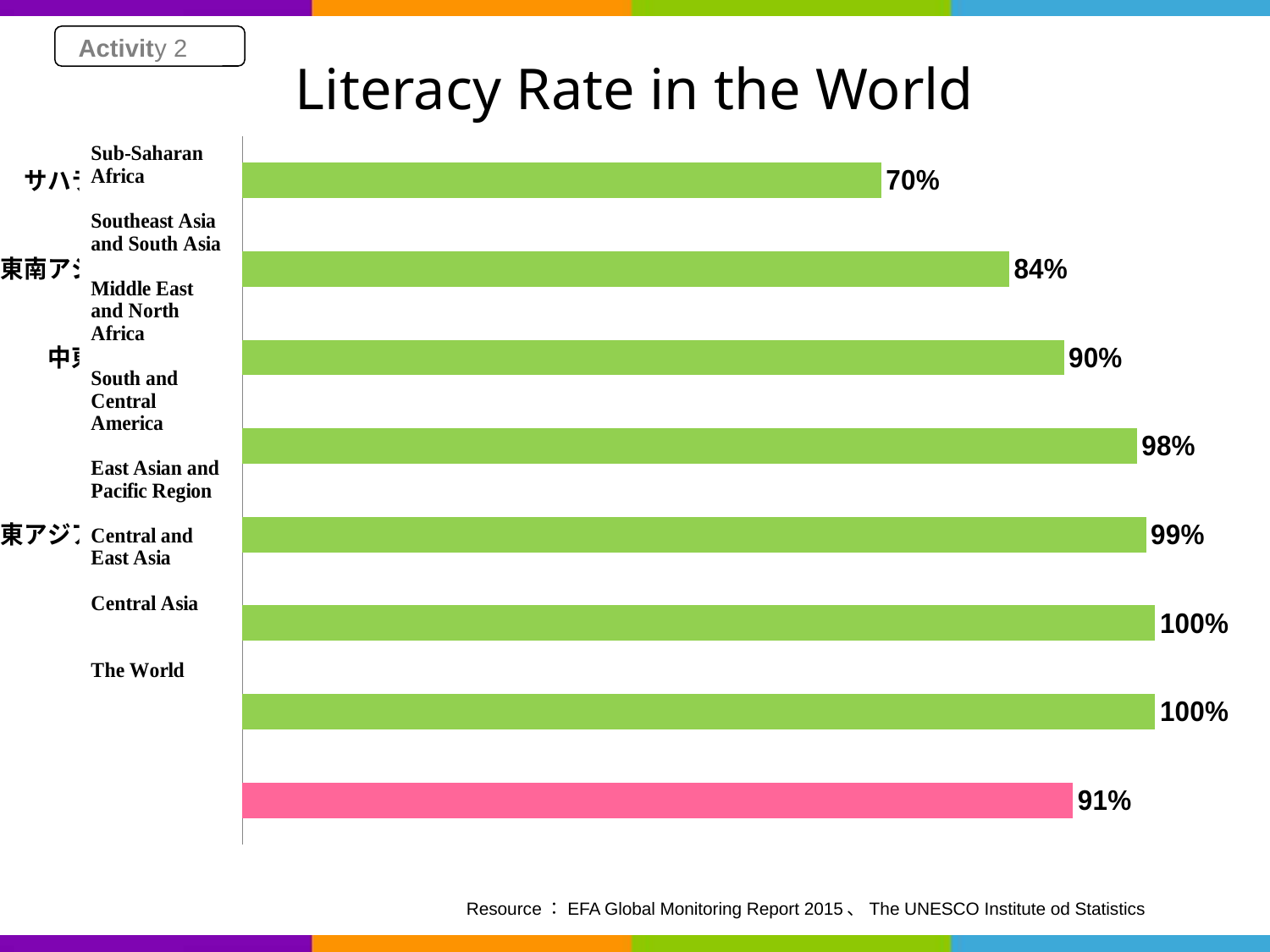
Which is larger, the literacy rate for South and Central America or for Middle East and North Africa? South and Central America What kind of chart is shown on the slide? Bar chart What is the literacy rate shown for Middle East and North Africa? 90% What is the literacy rate shown for Sub-Saharan Africa? 70% What is the difference between the literacy rate of The World and that of Sub-Saharan Africa? 21% What is the title of the chart? Literacy Rate in the World What is the literacy rate shown for The World? 91% How many bars are plotted on the chart? 8 Which region has the lowest literacy rate on the chart? Sub-Saharan Africa What is the literacy rate shown for Southeast Asia and South Asia? 84% Which bar is shown in a different colour (pink) from the others? The World What is the difference between the literacy rate of Southeast Asia and South Asia and that of Sub-Saharan Africa? 14%